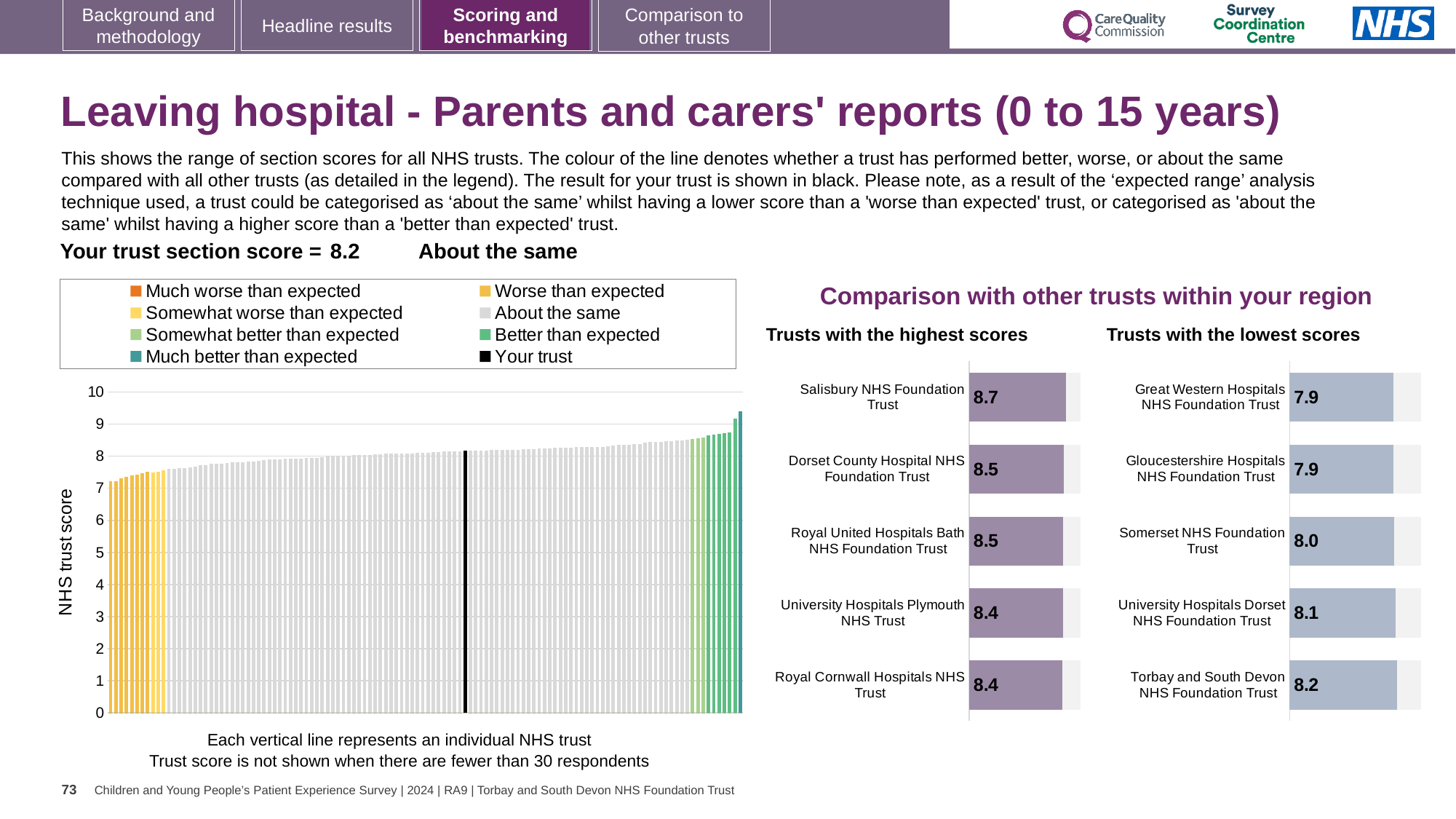
In the 'Trusts with the lowest scores' chart, what is the score for Torbay and South Devon NHS Foundation Trust? 8.2 In the 'Trusts with the highest scores' chart, which trust has the highest score? Salisbury NHS Foundation Trust In the 'Trusts with the lowest scores' chart, which has the larger score: University Hospitals Dorset NHS Foundation Trust or Great Western Hospitals NHS Foundation Trust? University Hospitals Dorset NHS Foundation Trust In the 'Trusts with the highest scores' chart, what is the score for Salisbury NHS Foundation Trust? 8.7 In the 'Trusts with the lowest scores' chart, what is the difference between the scores of Torbay and South Devon NHS Foundation Trust and Somerset NHS Foundation Trust? 0.2 In the 'Trusts with the lowest scores' chart, what is the score for Somerset NHS Foundation Trust? 8.0 In the 'Trusts with the highest scores' chart, how many trusts are listed? 5 In the 'Trusts with the highest scores' chart, what is the difference between the scores of Salisbury NHS Foundation Trust and Royal Cornwall Hospitals NHS Trust? 0.3 In the 'Trusts with the lowest scores' chart, which trust has the highest score? Torbay and South Devon NHS Foundation Trust In the 'Trusts with the highest scores' chart, what is the score for University Hospitals Plymouth NHS Trust? 8.4 In the NHS trust score chart on the left, is the value of the lowest bar greater or less than 8? less How many entries does the legend of the NHS trust score chart on the left list? 8